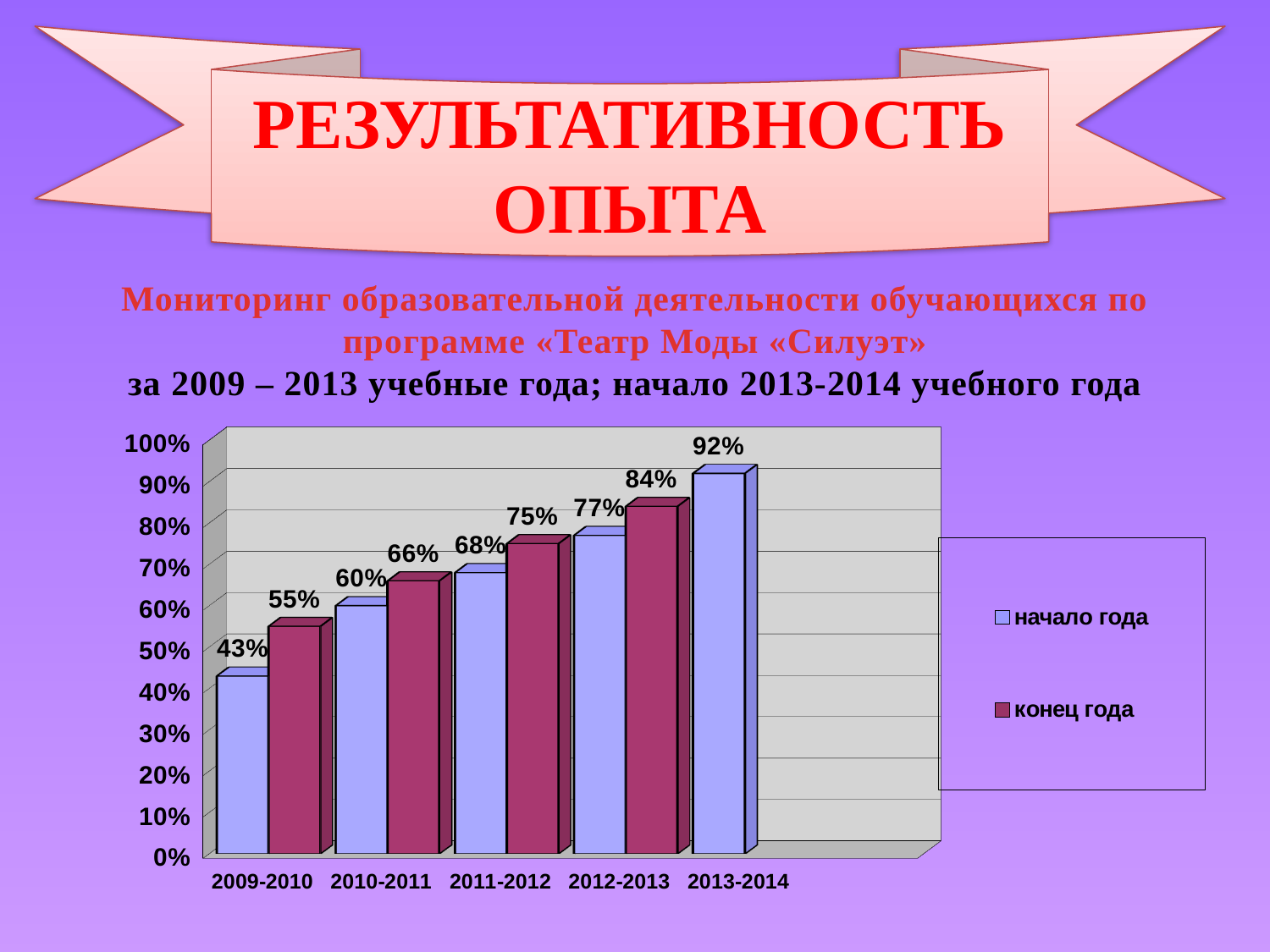
How many series does the legend list? 2 Which academic year has the highest value for "начало года"? 2013-2014 What is the value for "конец года" in 2010-2011? 66% Which is larger: the "начало года" value in 2012-2013 or the "конец года" value in 2011-2012? начало года in 2012-2013 How many academic years are shown on the x axis? 5 What kind of chart is shown on the slide? Bar chart What is the difference between the "конец года" and "начало года" values in 2009-2010? 12% What is the value for "начало года" in 2013-2014? 92% Which academic year has the lowest value for "конец года"? 2009-2010 What is the value for "конец года" in 2012-2013? 84% What is the value for "начало года" in 2009-2010? 43% Do the "начало года" values rise or fall from 2009-2010 to 2013-2014? Rise